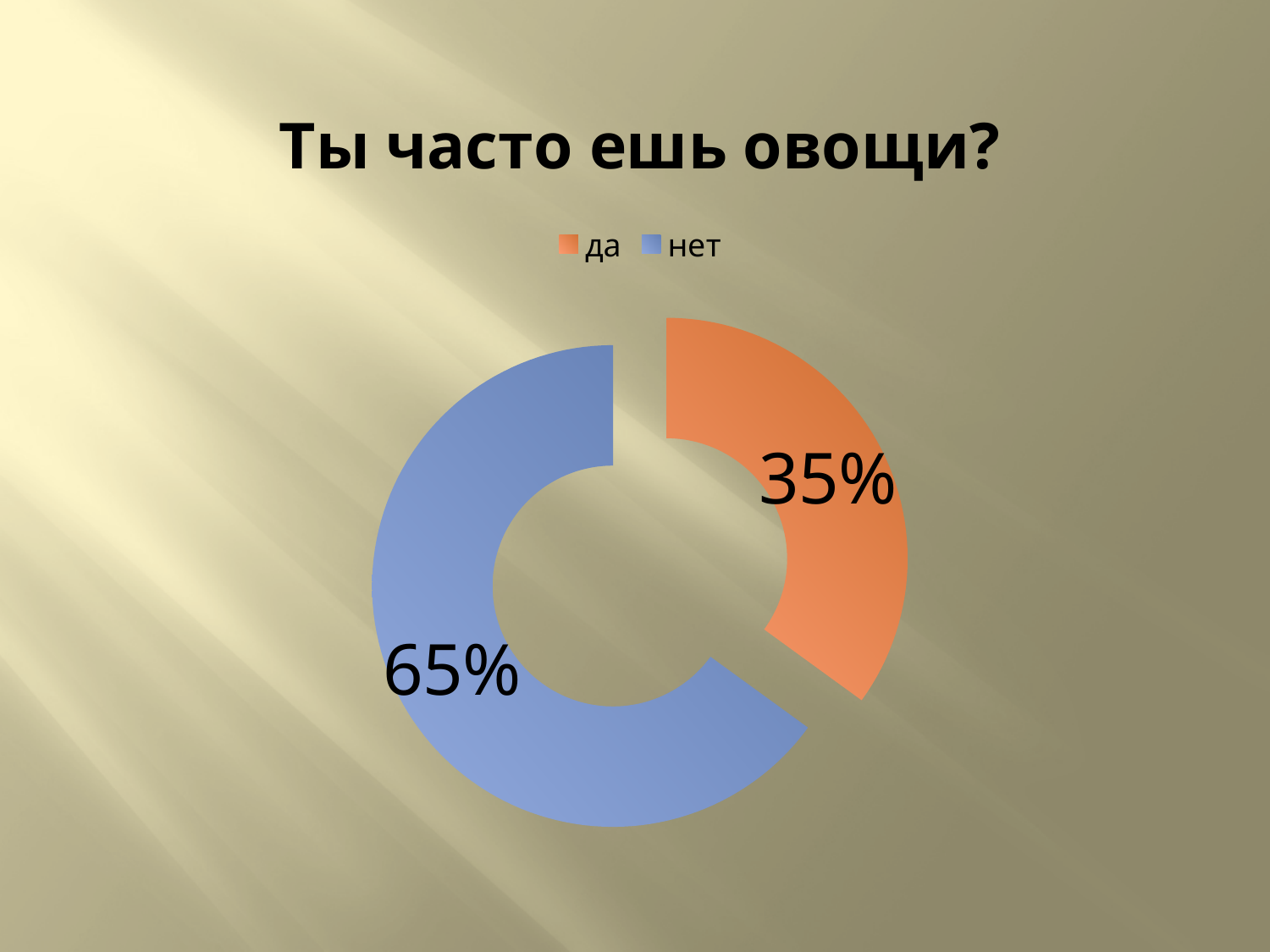
What kind of chart is shown on the slide? Doughnut chart What share of the chart does the "нет" slice take? 65% What percentage of respondents answered "нет"? 65% How many entries does the legend list? 2 Which answer has the largest share of the chart? нет What percentage of respondents answered "да"? 35% How many categories does the chart show? 2 Which is larger, the share for "да" or the share for "нет"? нет Which answer has the smallest share of the chart? да What is the difference in percentage points between "нет" and "да"? 30 What colour represents "да" in the chart? Orange What is the title of the chart? Ты часто ешь овощи?